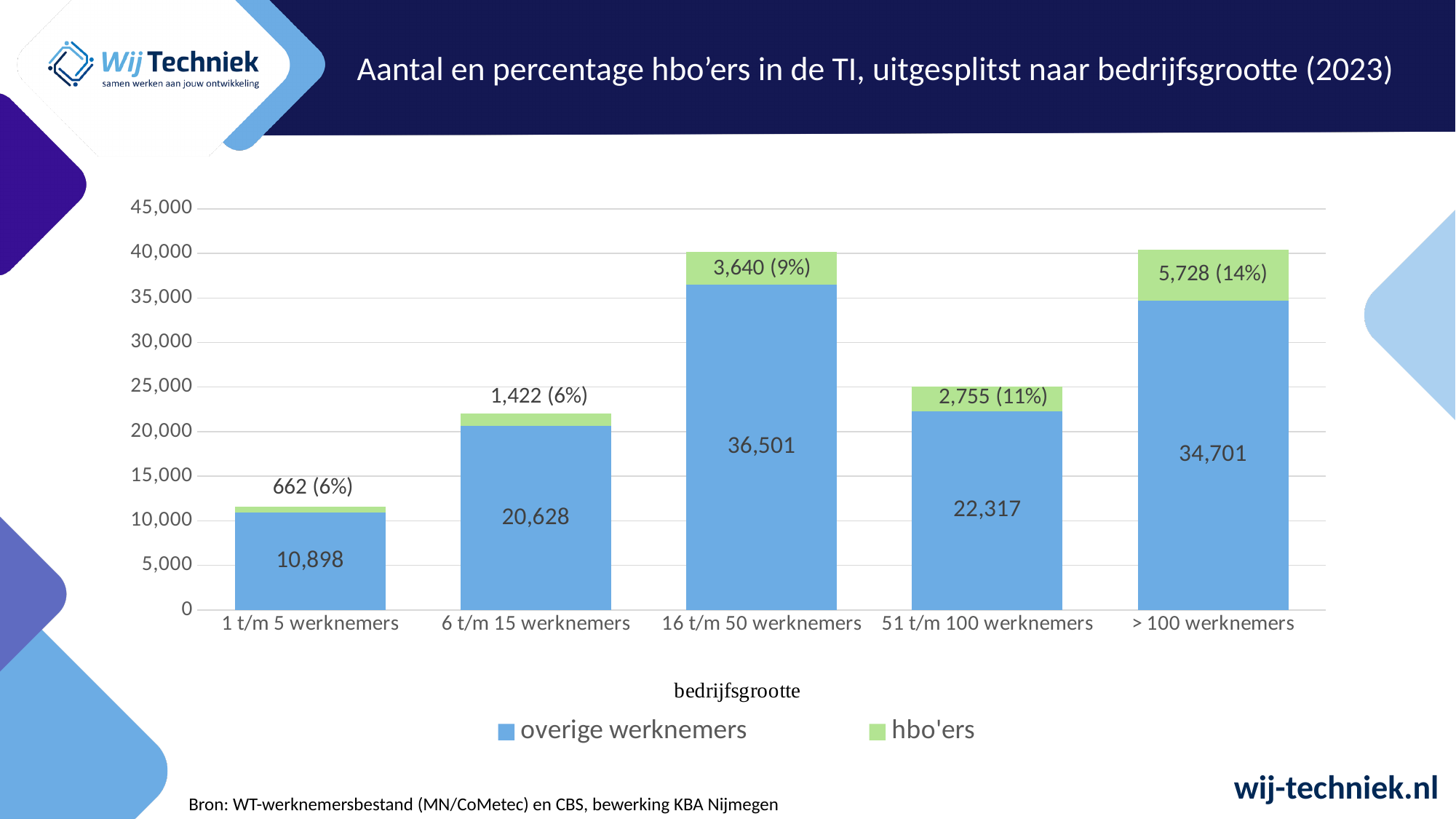
Which category has the lowest number of overige werknemers? 1 t/m 5 werknemers What type of chart is shown on the slide? stacked bar chart What is the value for overige werknemers in the 1 t/m 5 werknemers category? 10,898 What is the value for hbo'ers in the > 100 werknemers category? 5,728 (14%) How many series does the legend list? 2 How many company-size categories are shown on the x axis? 5 What is the total of the stacked bar for 6 t/m 15 werknemers? 22,050 Which is larger: the number of hbo'ers for 16 t/m 50 werknemers or for 51 t/m 100 werknemers? 16 t/m 50 werknemers What is the difference between the overige werknemers values for 16 t/m 50 werknemers and > 100 werknemers? 1,800 What is the value for overige werknemers in the 16 t/m 50 werknemers category? 36,501 Which category has the highest number of hbo'ers? > 100 werknemers What is the title of the chart? Aantal en percentage hbo'ers in de TI, uitgesplitst naar bedrijfsgrootte (2023)